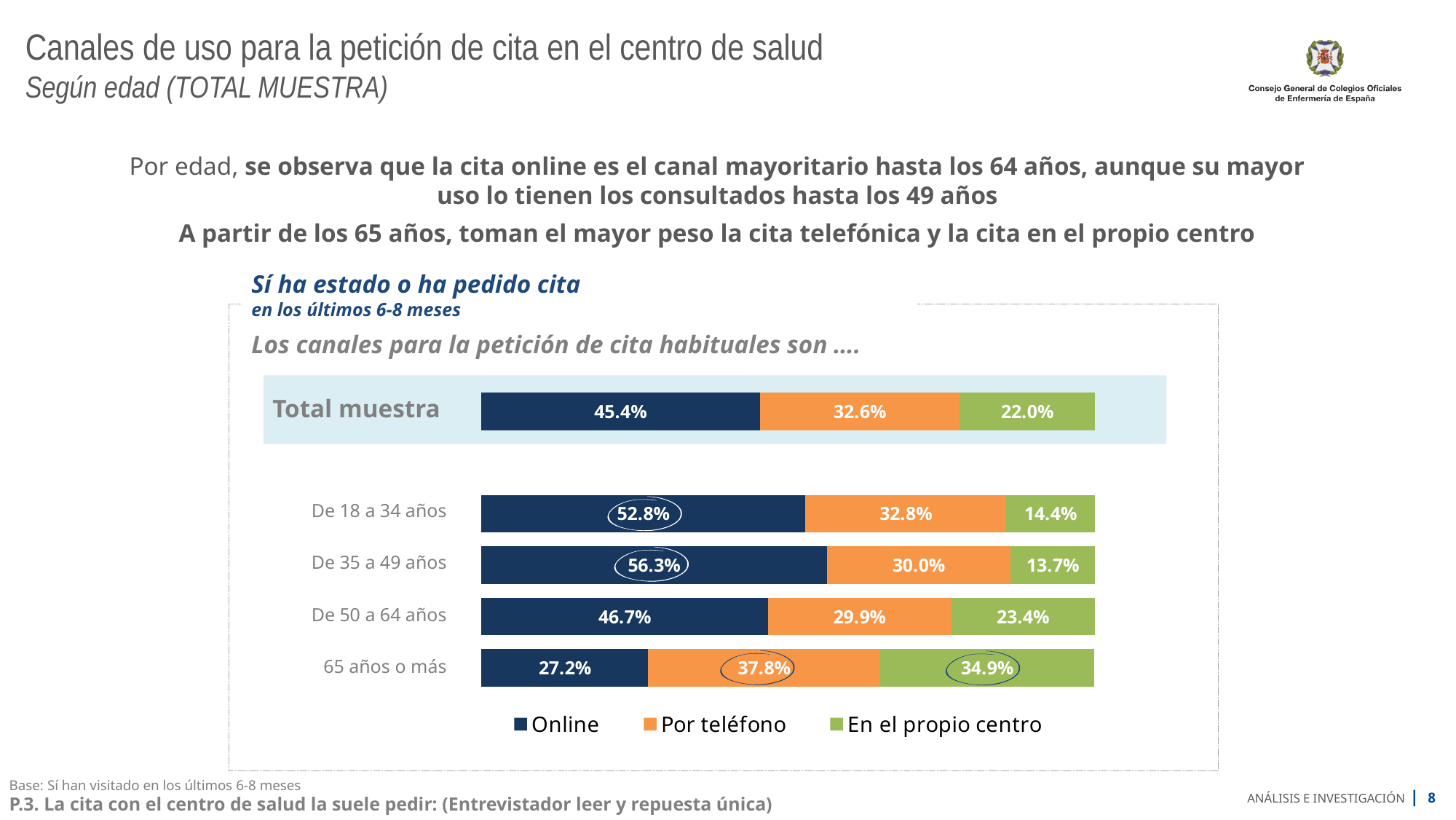
What is the total of the three segments for the 'De 50 a 64 años' bar? 100.0% What is the 'Por teléfono' value for the '65 años o más' age group? 37.8% How many series does the legend list? 3 Which age group has the highest Online value? De 35 a 49 años What is the Online value for the 'De 35 a 49 años' age group? 56.3% Which age group has the lowest 'En el propio centro' value? De 35 a 49 años What kind of chart is shown on the slide? Stacked bar chart Which series is shown in orange in the legend? Por teléfono How many age groups are shown in the chart, excluding the 'Total muestra' row? 4 What is the difference between the Online values for 'De 18 a 34 años' and '65 años o más'? 25.6% Which is larger for the '65 años o más' group: the 'Por teléfono' value or the 'En el propio centro' value? Por teléfono What is the 'En el propio centro' value for 'Total muestra'? 22.0%